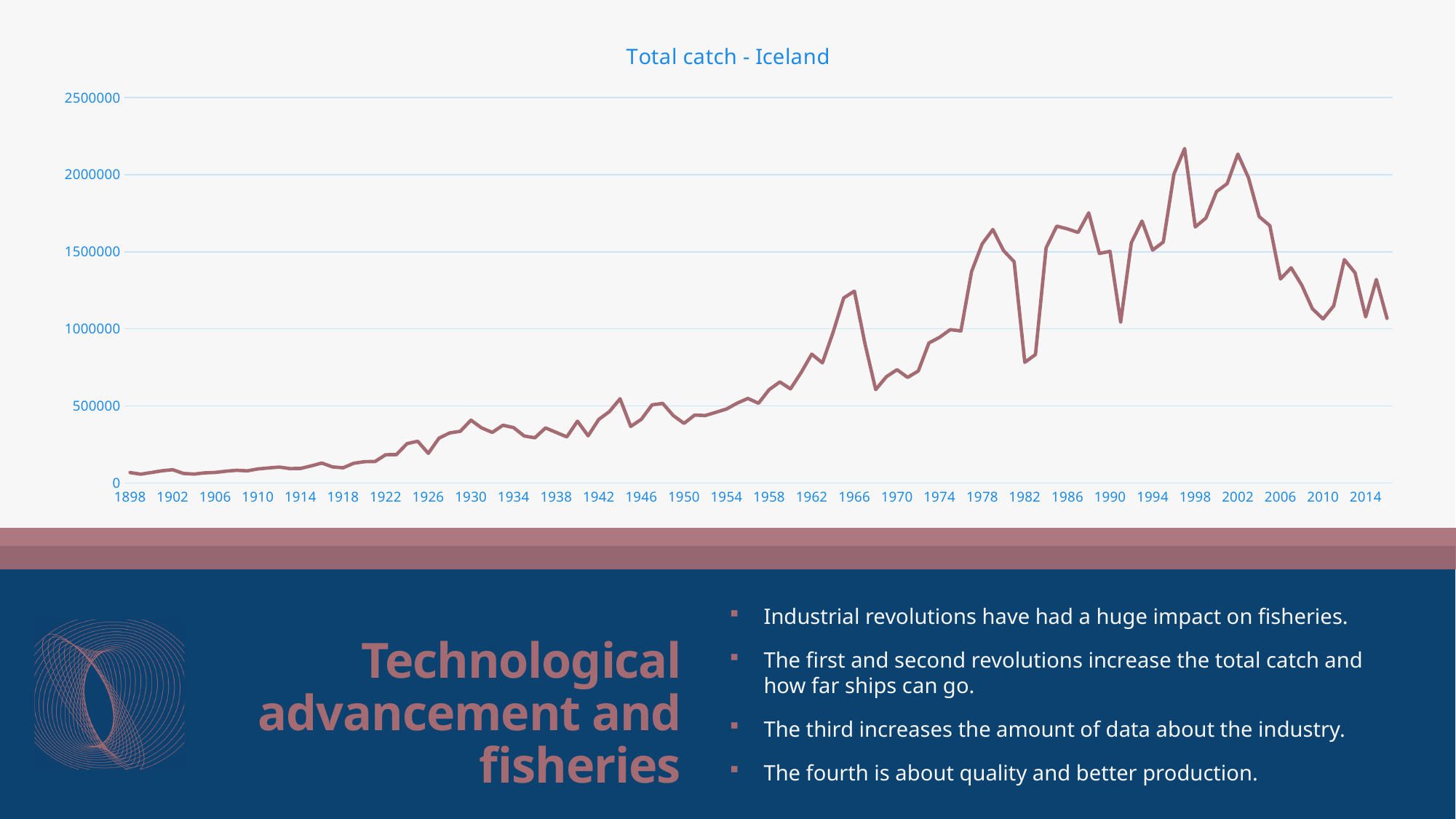
Is the value for 1930 greater or less than 500000? less What is the first year labelled on the x axis of the chart? 1898 Does the total catch generally rise or fall between 1898 and 1930? rise Which year has the larger value, 1966 or 1970? 1966 What is the title of the chart? Total catch - Iceland Which year has the larger value, 1898 or 2014? 2014 Is the value for 1898 greater or less than 500000? less Is the value for 2010 greater or less than 1500000? less What kind of chart is shown on the slide? line chart